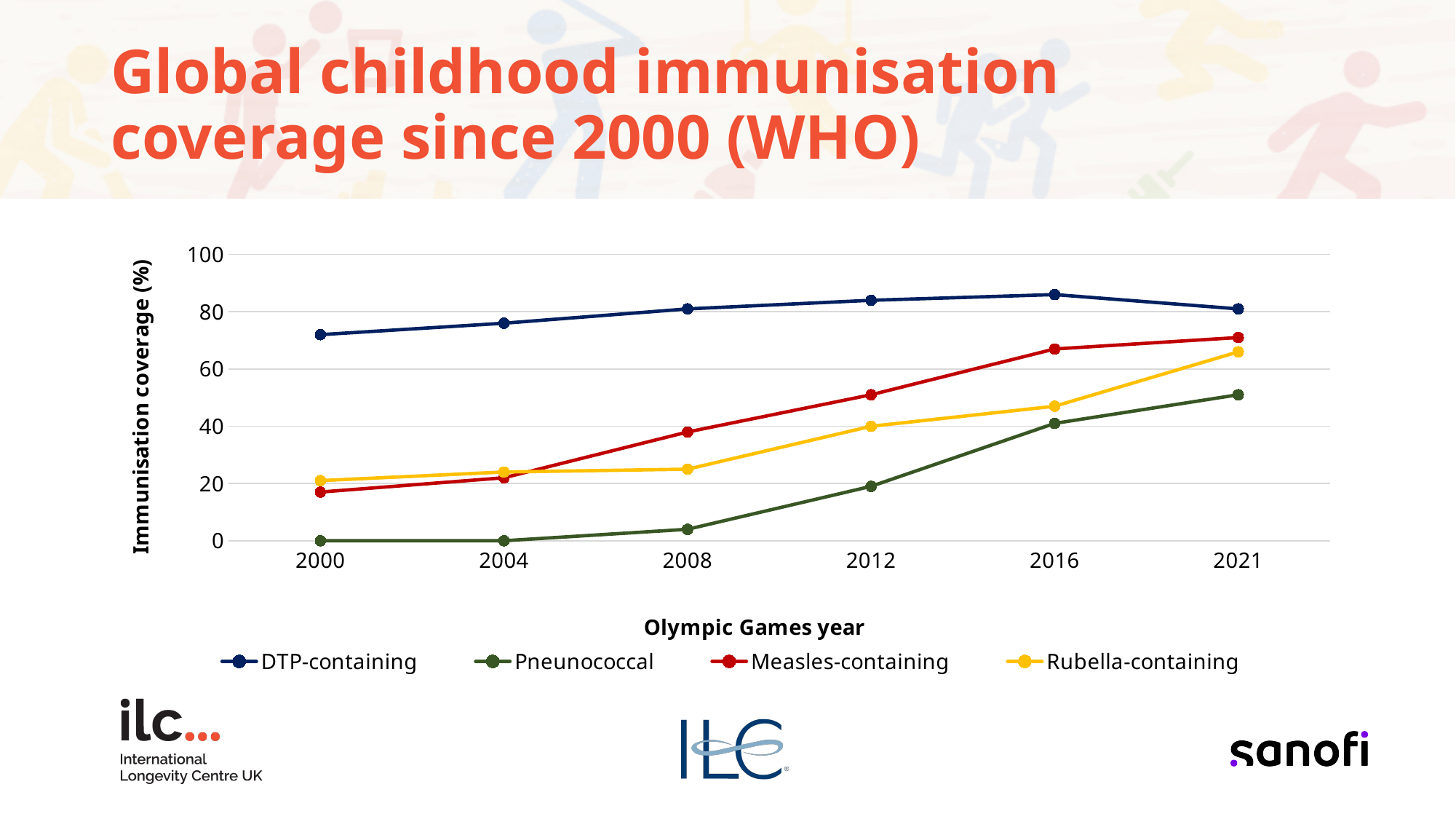
Is the value for DTP-containing in 2016 greater or less than 80? greater Does the Pneunococcal series rise or fall from 2000 to 2021? rise How many series does the legend list? 4 Which series has the highest immunisation coverage in 2021? DTP-containing What is the title of the x axis? Olympic Games year Which series has the lowest immunisation coverage in 2008? Pneunococcal Which is larger in 2016, the value for Measles-containing or the value for Rubella-containing? Measles-containing What kind of chart is shown on the slide? line chart How many Olympic Games years are plotted along the x axis? 6 Is the value for Rubella-containing in 2008 greater or less than 40? less Is the value for Measles-containing in 2012 greater or less than 40? greater